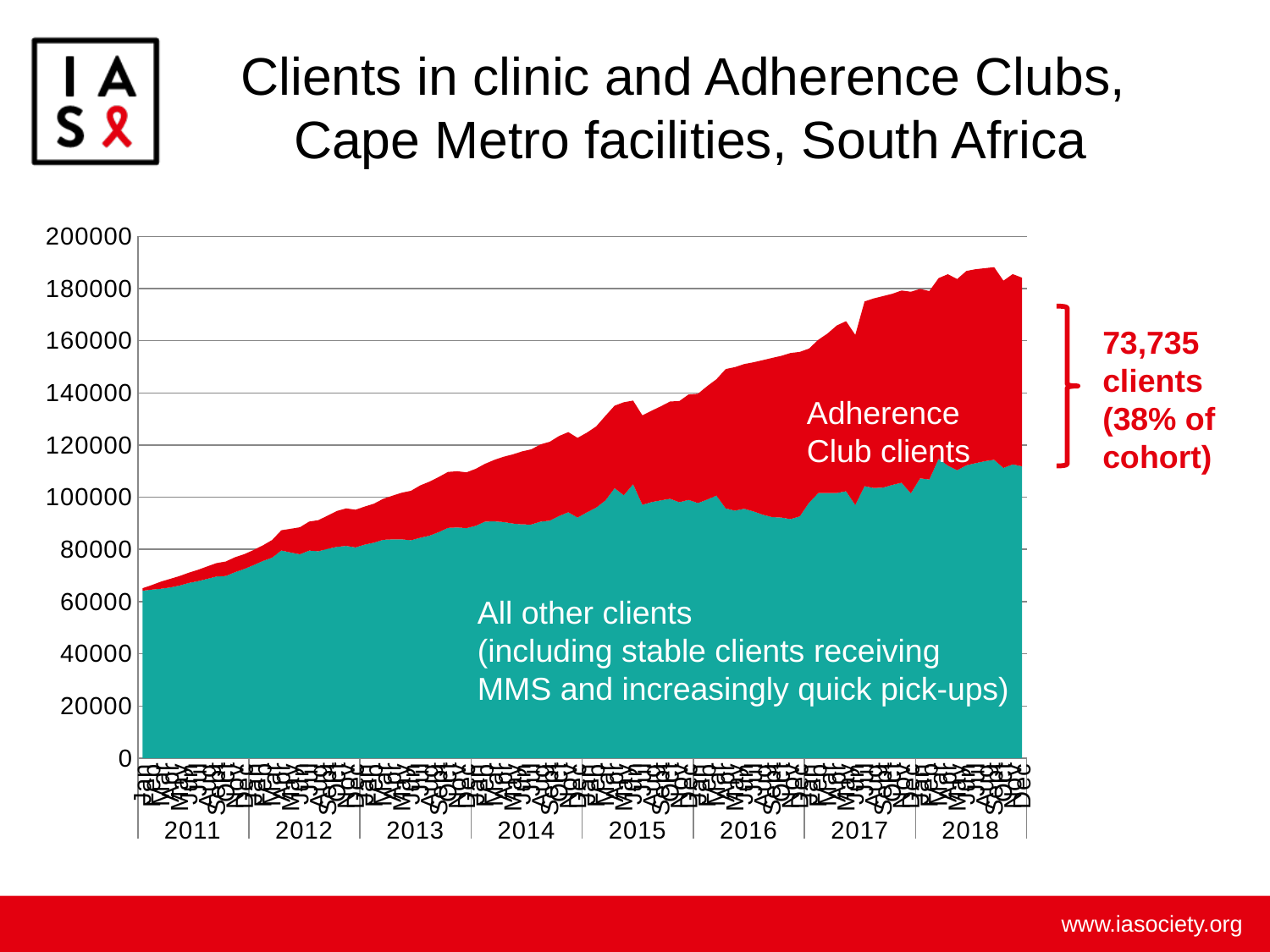
What kind of chart is shown on the slide? Area chart Is the number of 'All other clients' at the end of 2018 greater or less than 100000? greater How many Adherence Club clients are indicated by the annotation at the end of the series? 73,735 Is the total number of clients at the start of 2011 greater or less than 80000? less How many client series are plotted in the chart? 2 How many years are labelled on the x axis? 8 Is the total number of clients at the end of 2018 greater or less than 160000? greater Does the total number of clients rise or fall from 2011 to 2018? Rise What is the title of the chart on the slide? Clients in clinic and Adherence Clubs, Cape Metro facilities, South Africa Which colour represents Adherence Club clients in the chart? Red At the end of 2018, which series is larger: Adherence Club clients or All other clients? All other clients What percentage of the cohort do Adherence Club clients represent according to the annotation? 38%